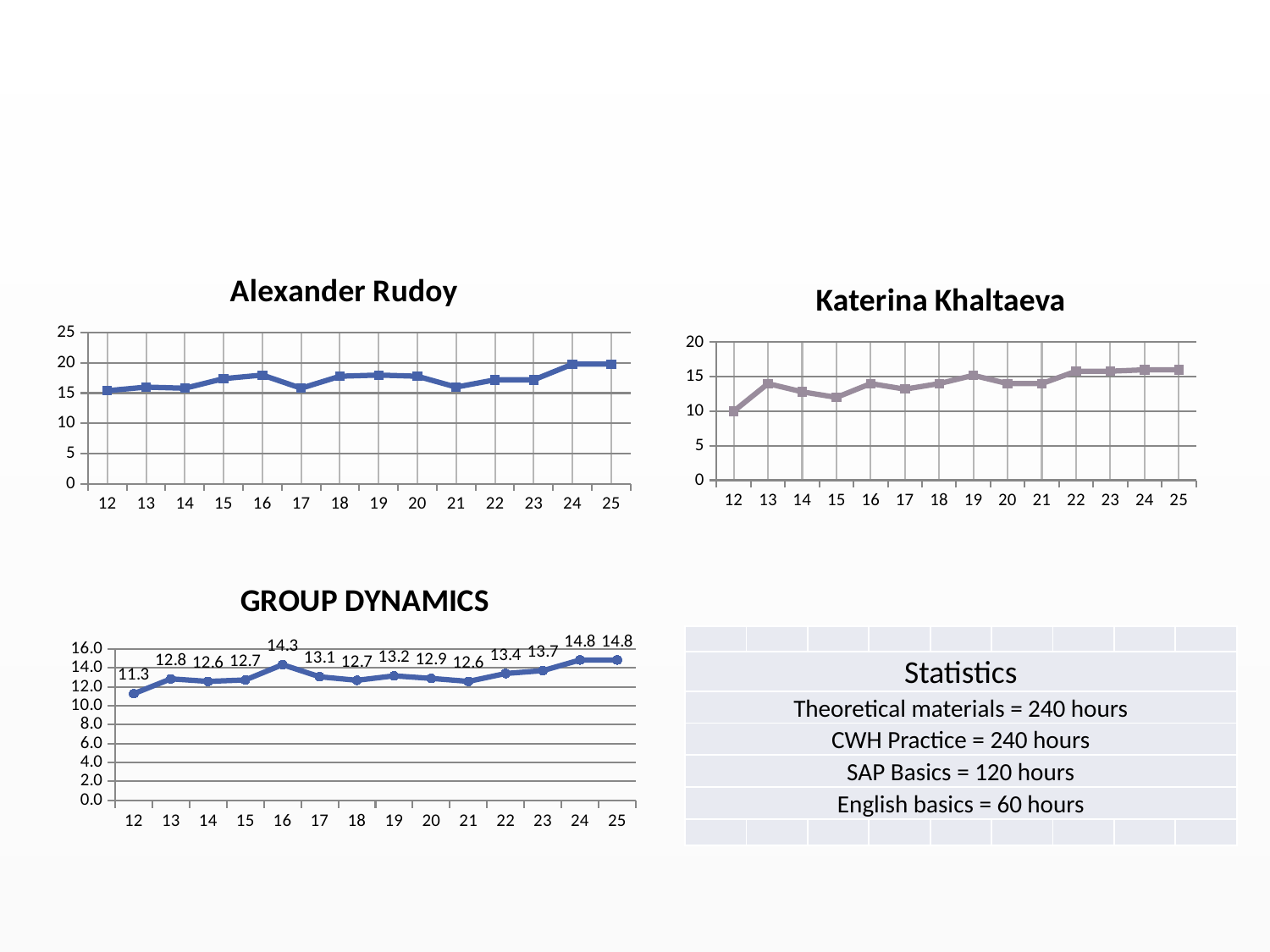
In the GROUP DYNAMICS chart, what is the value for 16? 14.3 In the GROUP DYNAMICS chart, what is the difference between the value for 25 and the value for 12? 3.5 What kind of chart is the Alexander Rudoy chart? line chart In the Katerina Khaltaeva chart, is the value for 22 greater or less than 15? greater In the Katerina Khaltaeva chart, is the value for 12 greater or less than 15? less How many data points are plotted in the GROUP DYNAMICS chart? 14 In the GROUP DYNAMICS chart, do the values overall rise or fall from 12 to 25? rise In the Katerina Khaltaeva chart, which x-axis category has the lowest value? 12 In the GROUP DYNAMICS chart, which x-axis category has the lowest value? 12 In the Alexander Rudoy chart, is the value for 12 greater or less than 20? less In the Alexander Rudoy chart, which is larger, the value for 24 or the value for 12? 24 In the GROUP DYNAMICS chart, what is the value for 12? 11.3